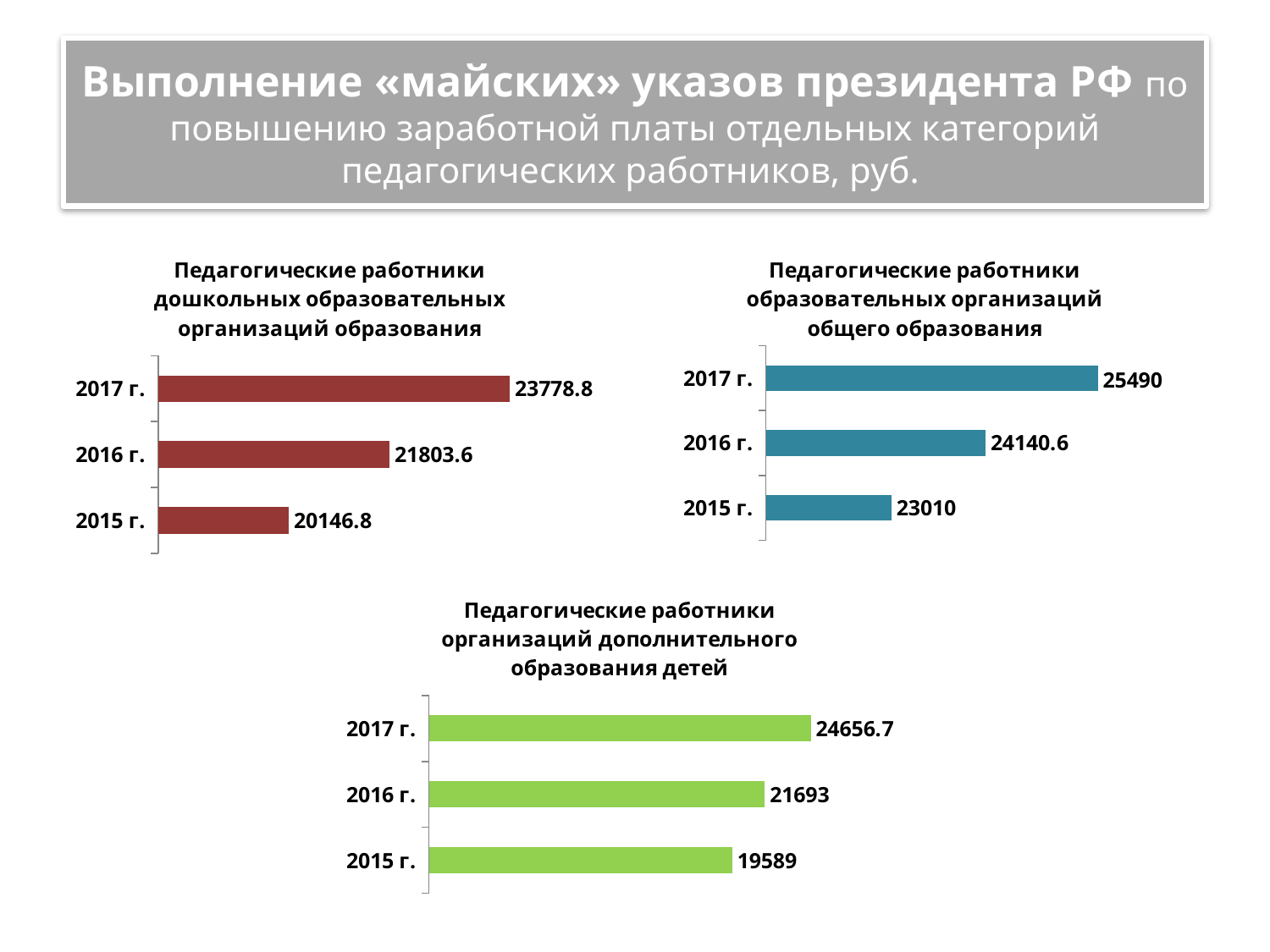
In the top-right chart (Педагогические работники образовательных организаций общего образования), what is the value for 2015 г.? 23010 In the top-right chart (общего образования), which year has the highest value? 2017 г. In the top-left chart (дошкольных образовательных организаций), which year has the lowest value? 2015 г. In the top-left chart (Педагогические работники дошкольных образовательных организаций образования), what is the value for 2017 г.? 23778.8 In the bottom chart (дополнительного образования детей), do the values rise or fall from 2015 г. to 2017 г.? Rise In the bottom chart (дополнительного образования детей), what is the difference between the values for 2017 г. and 2016 г.? 2963.7 In the top-right chart (общего образования), what is the difference between the values for 2017 г. and 2015 г.? 2480 In the top-left chart (дошкольных образовательных организаций), which is larger: the value for 2016 г. or the value for 2015 г.? 2016 г. In the bottom chart (Педагогические работники организаций дополнительного образования детей), what is the value for 2016 г.? 21693 What kind of chart is the top-right chart (общего образования)? Bar chart What colour are the bars in the bottom chart (дополнительного образования детей)? Green How many years (categories) are shown in the bottom chart (дополнительного образования детей)? 3